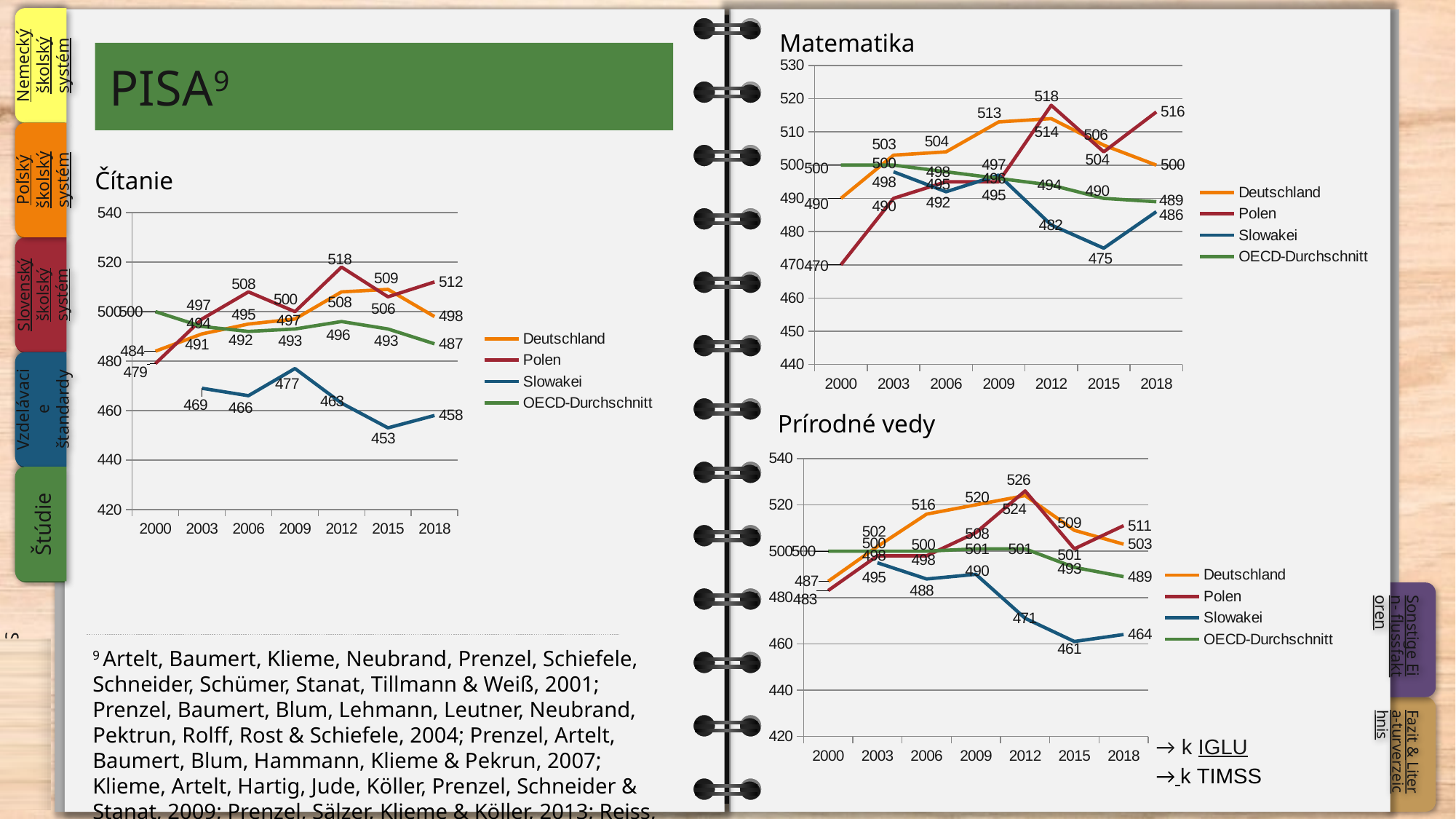
In the Matematika chart, which is larger in 2018, Polen or Deutschland? Polen What kind of chart is the Matematika chart? Line chart How many series does the legend of the Prírodné vedy chart list? 4 In the Matematika chart, what is the value for Deutschland in 2012? 514 In the Matematika chart, what is the difference between Polen in 2000 and Polen in 2018? 46 In the Čítanie chart, what is the difference between Deutschland and Polen in 2018? 14 In the Čítanie chart, what is the value for Polen in 2012? 518 In the Prírodné vedy chart, what is the value for Slowakei in 2015? 461 In the Čítanie chart, which year has the lowest value for Slowakei? 2015 In the Matematika chart, which year has the highest value for Polen? 2012 In the Čítanie chart, what is the value for Slowakei in 2015? 453 In the Prírodné vedy chart, what is the value for Polen in 2012? 526